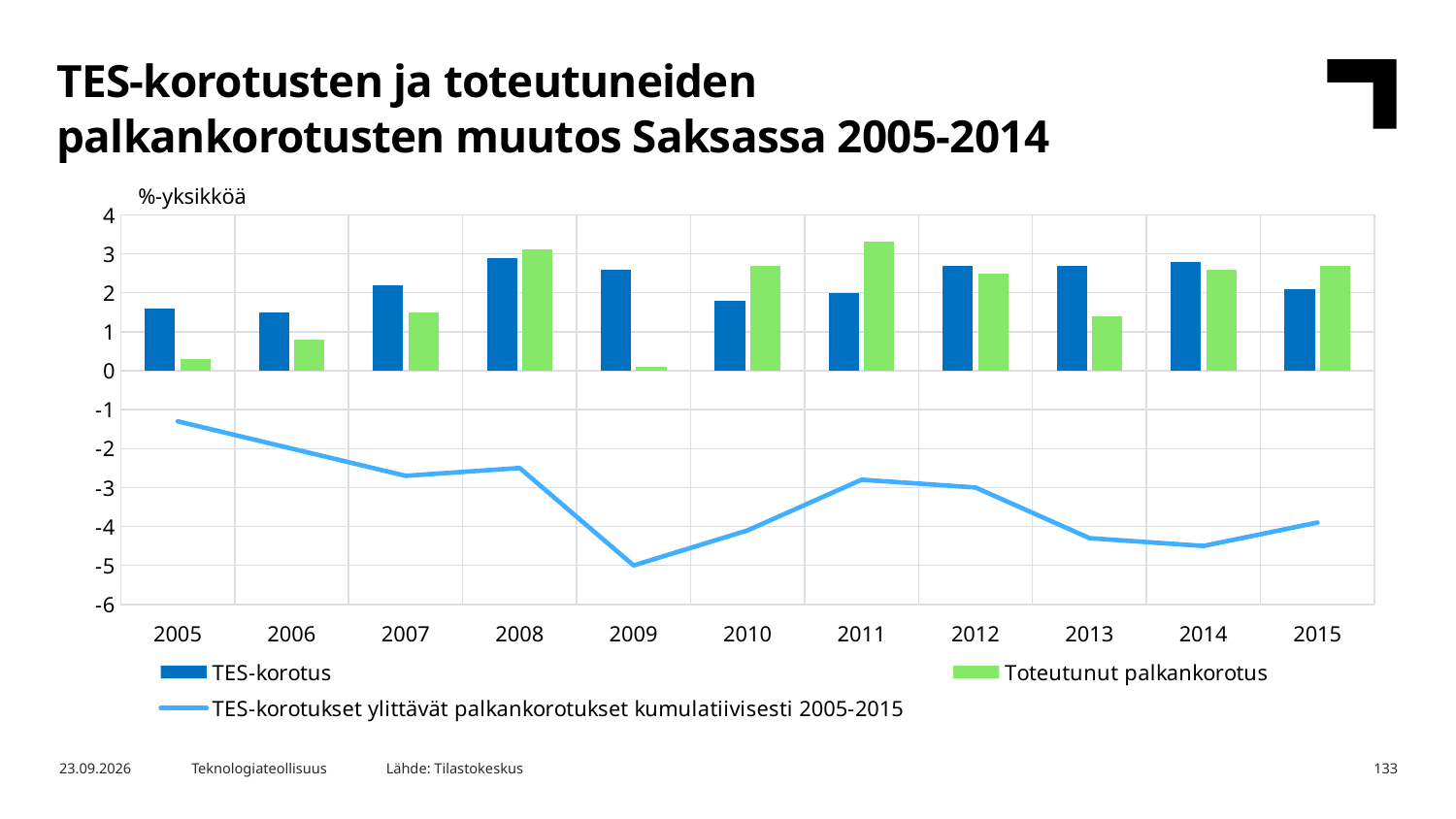
In which year is the Toteutunut palkankorotus bar the highest? 2011 What unit label is shown above the vertical axis? %-yksikköä Does the cumulative line rise or fall from 2005 to 2009? It falls Is the value of the cumulative line (TES-korotukset ylittävät palkankorotukset kumulatiivisesti 2005-2015) in 2009 greater or less than -4? less Is the TES-korotus value for 2008 greater or less than 2? greater In 2005, which is larger: TES-korotus or Toteutunut palkankorotus? TES-korotus How many years are shown on the x axis of the chart? 11 In which year is the Toteutunut palkankorotus bar the lowest? 2009 Which series is drawn as a line rather than bars? TES-korotukset ylittävät palkankorotukset kumulatiivisesti 2005-2015 In 2011, which is larger: TES-korotus or Toteutunut palkankorotus? Toteutunut palkankorotus How many series does the legend list? 3 What kind of chart is shown on the slide? A combined bar and line chart